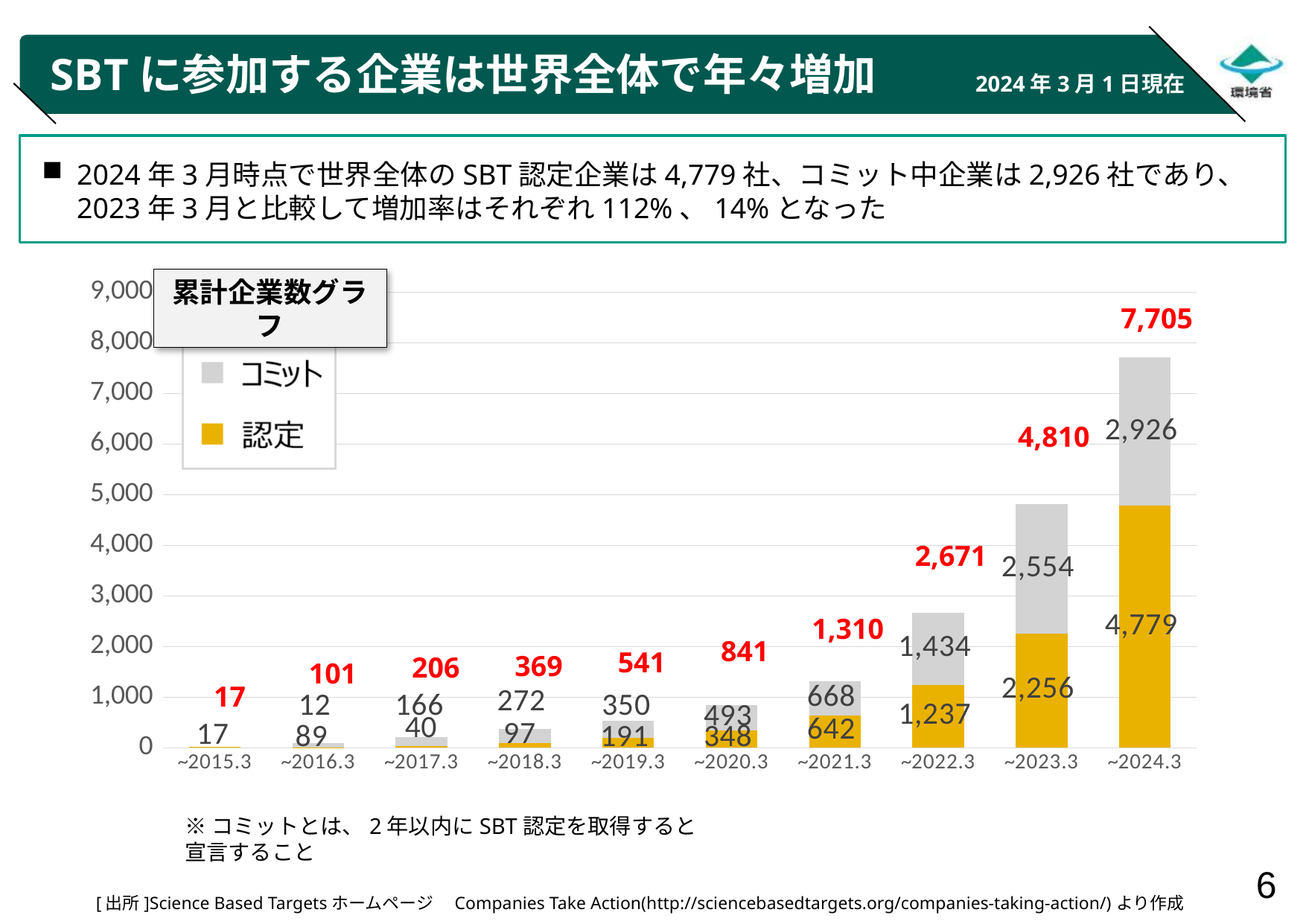
Which period has the highest total number of companies? ~2024.3 Which colour represents the 認定 series in the chart? gold (yellow-orange) How many categories (time periods) are shown on the x axis of the chart? 10 What is the value of 認定 for ~2024.3? 4,779 How many series does the chart legend list? 2 What is the value of コミット for ~2023.3? 2,554 What is the total shown above the stacked bar for ~2022.3? 2,671 What is the difference between the 認定 values for ~2024.3 and ~2023.3? 2,523 For ~2021.3, which is larger: コミット or 認定? コミット Do the total values rise or fall from ~2015.3 to ~2024.3? rise What type of chart is shown on the slide? stacked bar chart Which period has the lowest total number of companies? ~2015.3